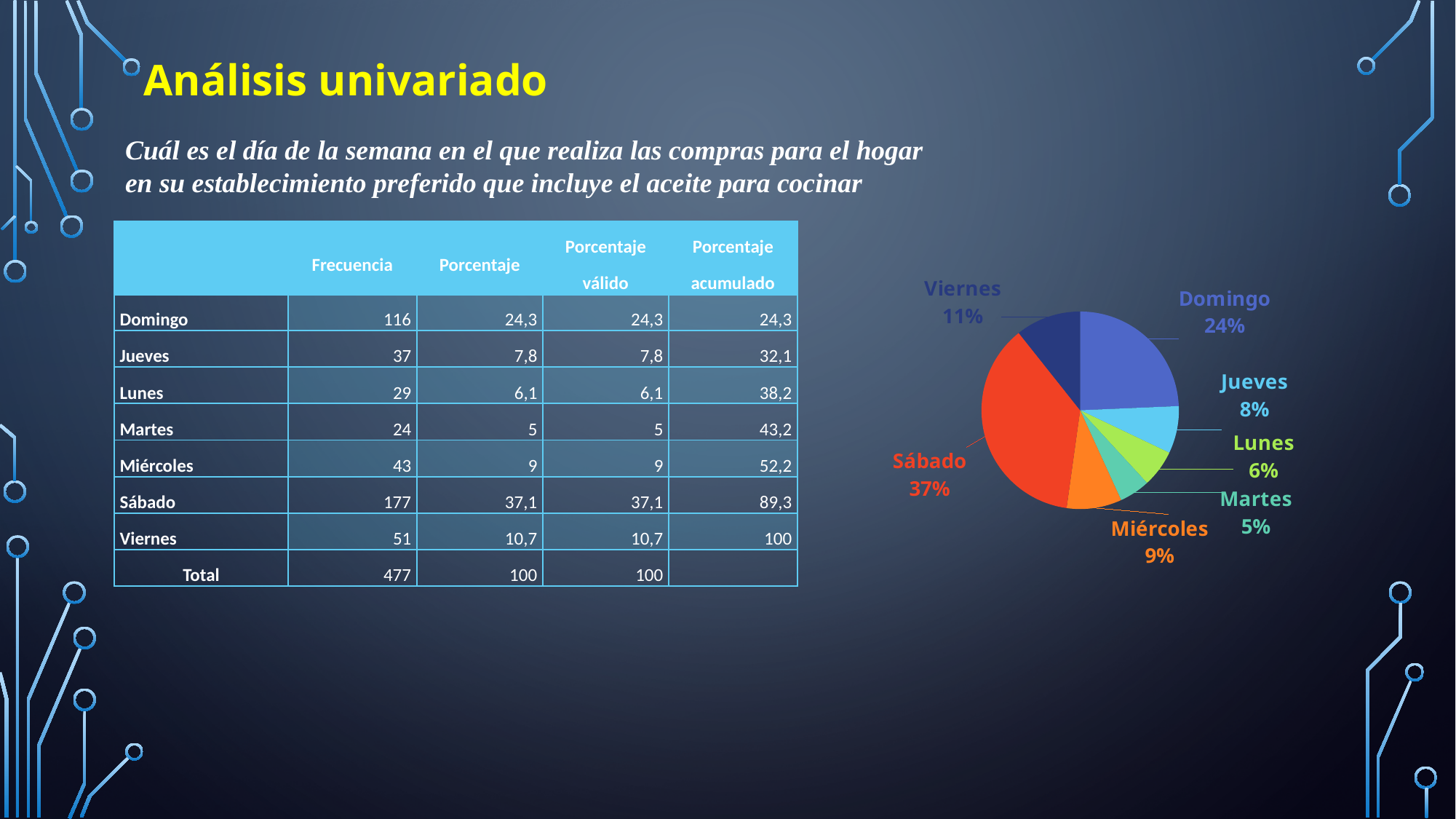
In the pie chart, what percentage is shown for Domingo? 24% What is the combined share of the Sábado and Domingo slices in the pie chart? 61% Which day has the smallest slice in the pie chart? Martes In the pie chart, which is larger, the slice for Jueves or the slice for Lunes? Jueves How many slices does the pie chart have? 7 Which day has the largest slice in the pie chart? Sábado In the pie chart, what percentage is shown for Sábado? 37% What colour is the Sábado slice in the pie chart? red What kind of chart is shown on the slide? pie chart In the pie chart, what percentage is shown for Viernes? 11% In the pie chart, what percentage is shown for Miércoles? 9% What is the difference in percentage points between the Sábado slice and the Domingo slice in the pie chart? 13